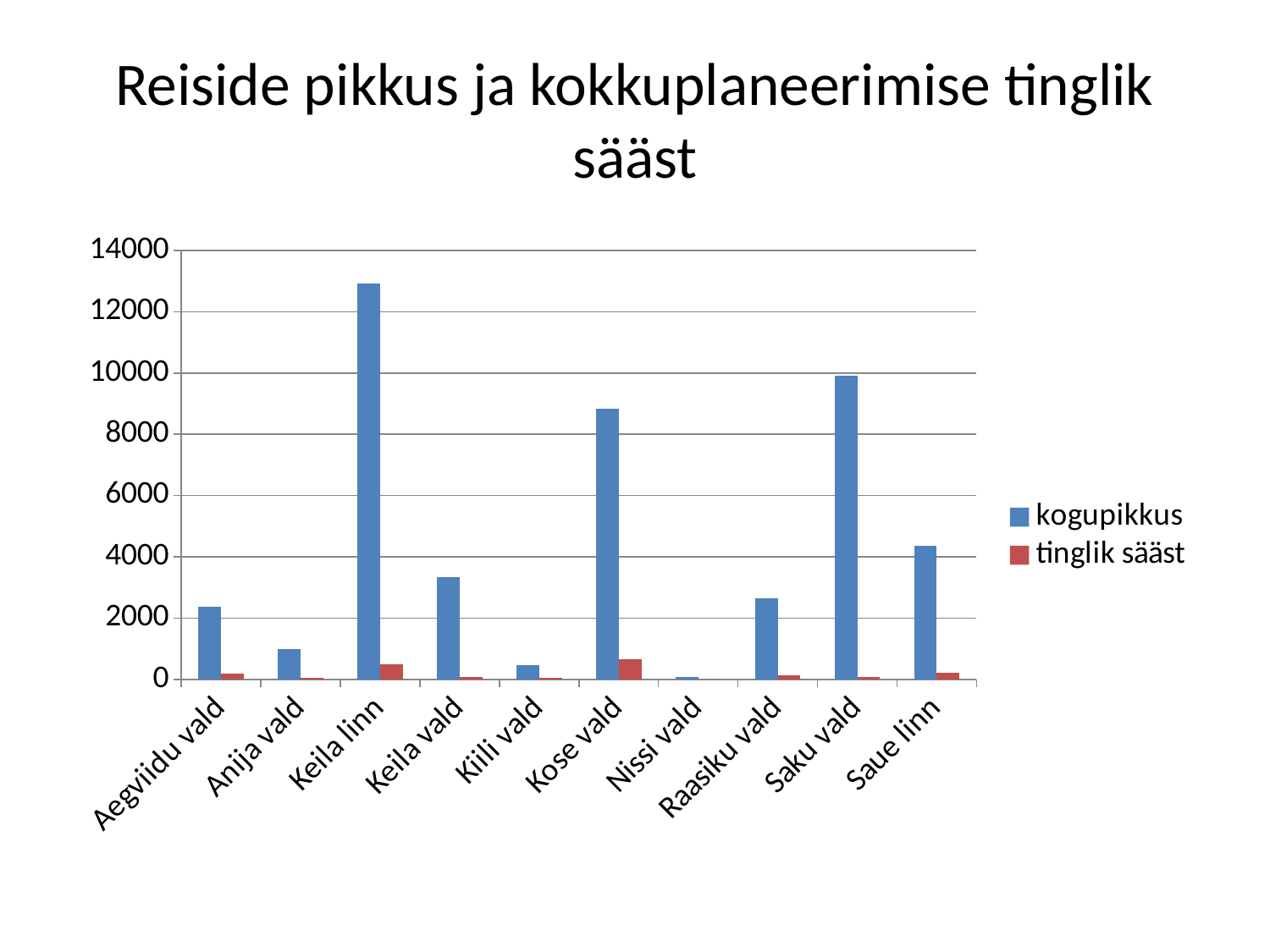
How many series does the legend list? 2 Is the kogupikkus value for Kose vald greater or less than 8000? greater What kind of chart is shown on the slide? bar chart Which category has the highest kogupikkus value? Keila linn How many categories are shown on the x axis of the chart? 10 Which has the larger kogupikkus value, Saku vald or Kose vald? Saku vald Which category has the highest tinglik sääst value? Kose vald Is the kogupikkus value for Keila vald greater or less than 4000? less Which category has the lowest kogupikkus value? Nissi vald Which has the larger kogupikkus value, Aegviidu vald or Anija vald? Aegviidu vald Is the kogupikkus value for Keila linn greater or less than 12000? greater What is the title of the chart on the slide? Reiside pikkus ja kokkuplaneerimise tinglik sääst